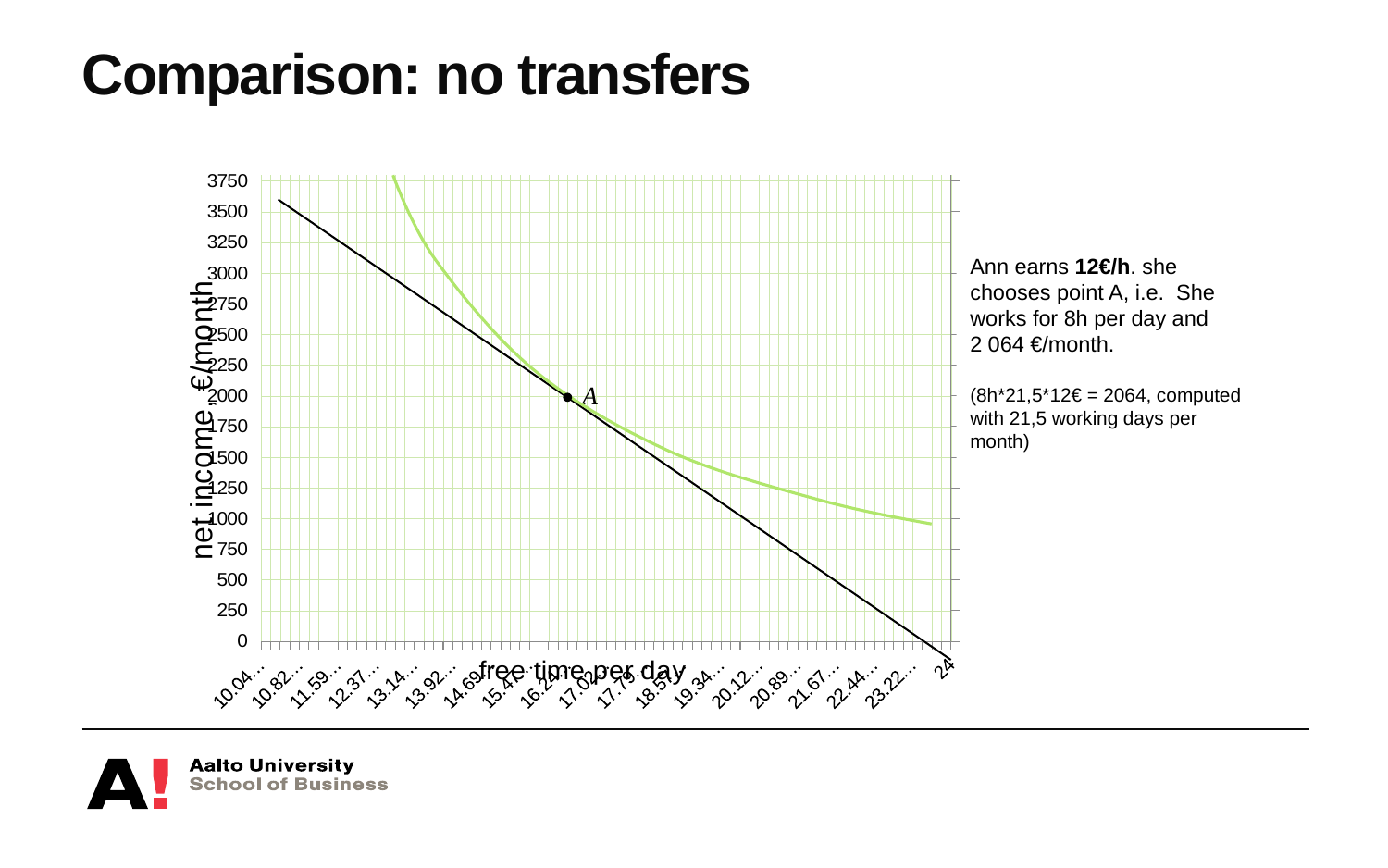
What is the last tick value shown on the horizontal axis? 24 What letter labels the marked point where the black line and the green curve touch? A What is the highest tick value shown on the vertical axis? 3750 Does the black straight line rise or fall as free time per day increases? fall How many lines (series) are plotted on the chart? 2 What is the label of the horizontal axis of the chart? free time per day Does the green curve rise or fall as free time per day increases? fall What is the label of the vertical axis of the chart? net income, €/month Is the value of the green curve at its right end (free time 24) greater or less than 1250? less According to the slide text, what net income per month does point A correspond to? 2 064 €/month Is the net income at point A greater or less than 2500? less What kind of chart is shown on the slide? line chart